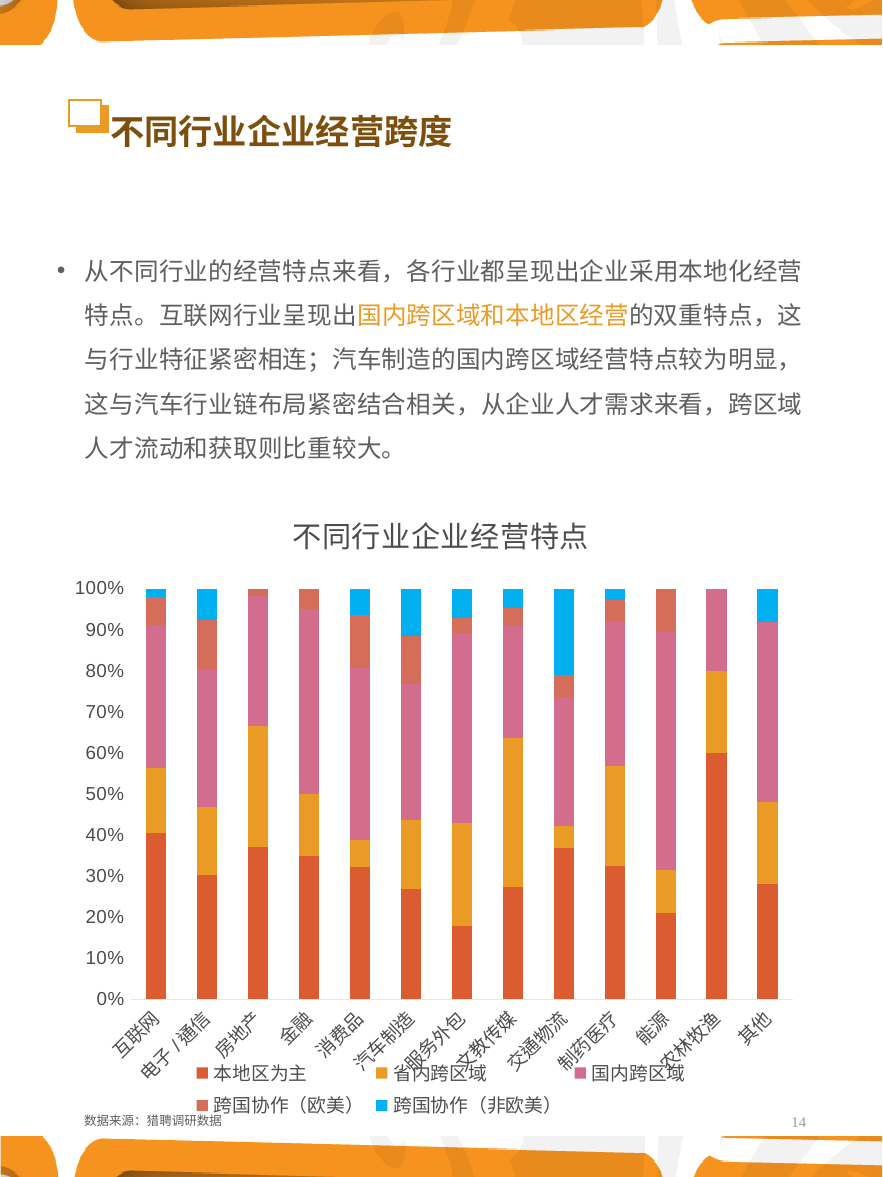
Which industry has the highest share of 本地区为主? 农林牧渔 Which has a larger 本地区为主 share, 互联网 or 服务外包? 互联网 How many industry categories are shown on the x axis of the chart? 13 Is the 本地区为主 share for 服务外包 greater or less than 20%? less Which has a larger 本地区为主 share, 农林牧渔 or 互联网? 农林牧渔 Is the 本地区为主 share for 农林牧渔 greater or less than 50%? greater Is the 本地区为主 share for 房地产 greater or less than 30%? greater How many series does the chart legend list? 5 What is the title of the chart? 不同行业企业经营特点 What kind of chart is shown on the slide? bar chart What data source is cited below the chart? 猎聘调研数据